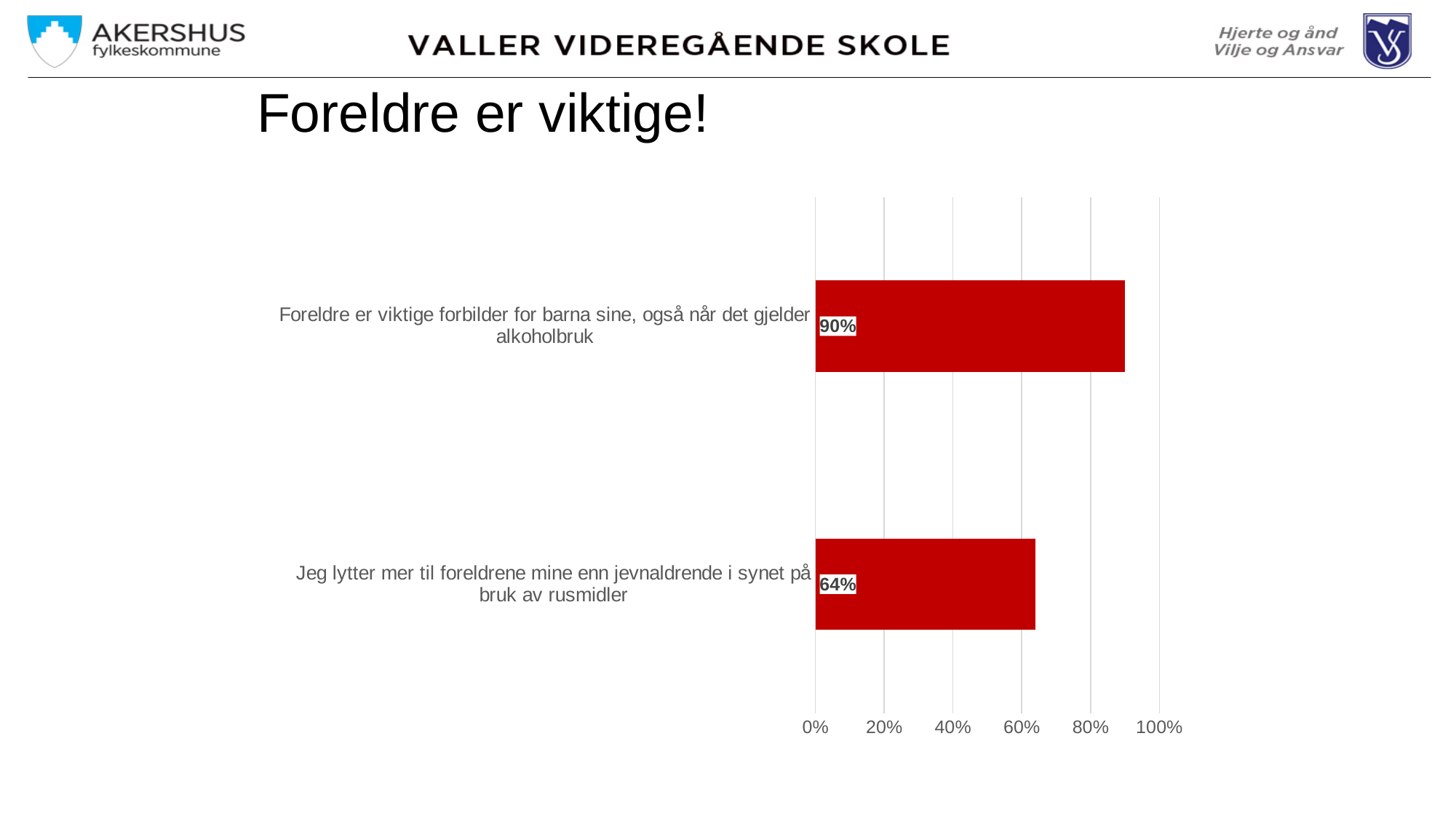
What is the value for "Foreldre er viktige forbilder for barna sine, også når det gjelder alkoholbruk"? 90% Which category has the highest value? Foreldre er viktige forbilder for barna sine, også når det gjelder alkoholbruk What colour are the bars in the chart? Red What is the title of the slide containing the chart? Foreldre er viktige! Which is larger: the value for "Foreldre er viktige forbilder for barna sine, også når det gjelder alkoholbruk" or the value for "Jeg lytter mer til foreldrene mine enn jevnaldrende i synet på bruk av rusmidler"? Foreldre er viktige forbilder for barna sine, også når det gjelder alkoholbruk How many categories are shown in the chart? 2 What kind of chart is shown on the slide? Bar chart What is the value for "Jeg lytter mer til foreldrene mine enn jevnaldrende i synet på bruk av rusmidler"? 64% Is the value for "Foreldre er viktige forbilder for barna sine, også når det gjelder alkoholbruk" greater or less than 80%? greater Is the value for "Jeg lytter mer til foreldrene mine enn jevnaldrende i synet på bruk av rusmidler" greater or less than 80%? less Which category has the lowest value? Jeg lytter mer til foreldrene mine enn jevnaldrende i synet på bruk av rusmidler What is the difference between the value for "Foreldre er viktige forbilder for barna sine, også når det gjelder alkoholbruk" and the value for "Jeg lytter mer til foreldrene mine enn jevnaldrende i synet på bruk av rusmidler"? 26%